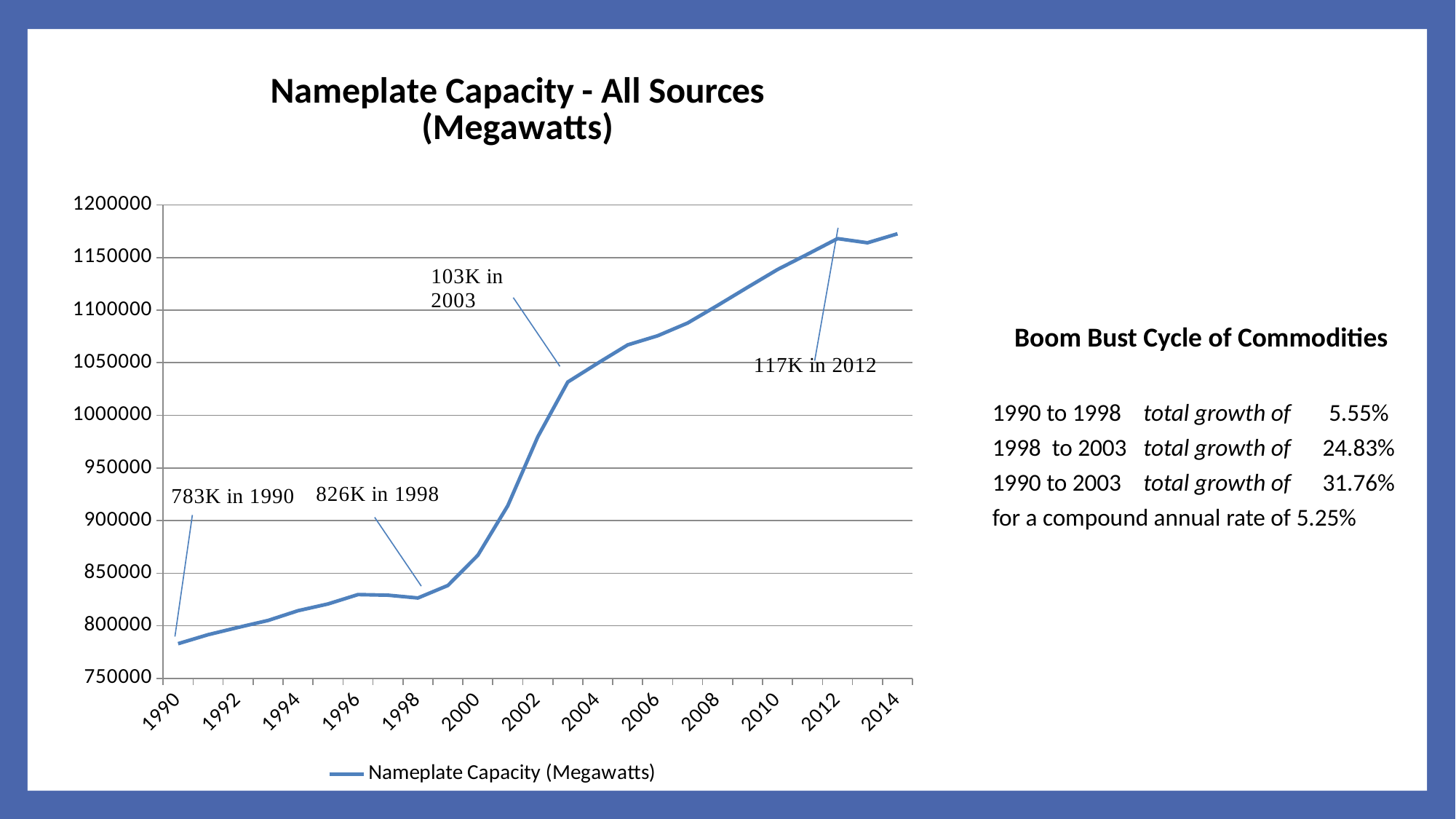
According to the annotation on the chart, what was the nameplate capacity in 1998? 826K Does nameplate capacity generally rise or fall from 1990 to 2014? rise Which year has the lowest nameplate capacity on the chart? 1990 What is the title of the chart? Nameplate Capacity - All Sources (Megawatts) What is the legend entry for the plotted series? Nameplate Capacity (Megawatts) Which year has the larger nameplate capacity, 1998 or 2003? 2003 According to the annotation on the chart, what was the nameplate capacity in 1990? 783K Is the value for 2014 greater or less than 1150000? greater What kind of chart is shown on the slide? line chart Is the value for 2003 greater or less than 1000000? greater How many series does the legend list? 1 Is the value for 1990 greater or less than 800000? less